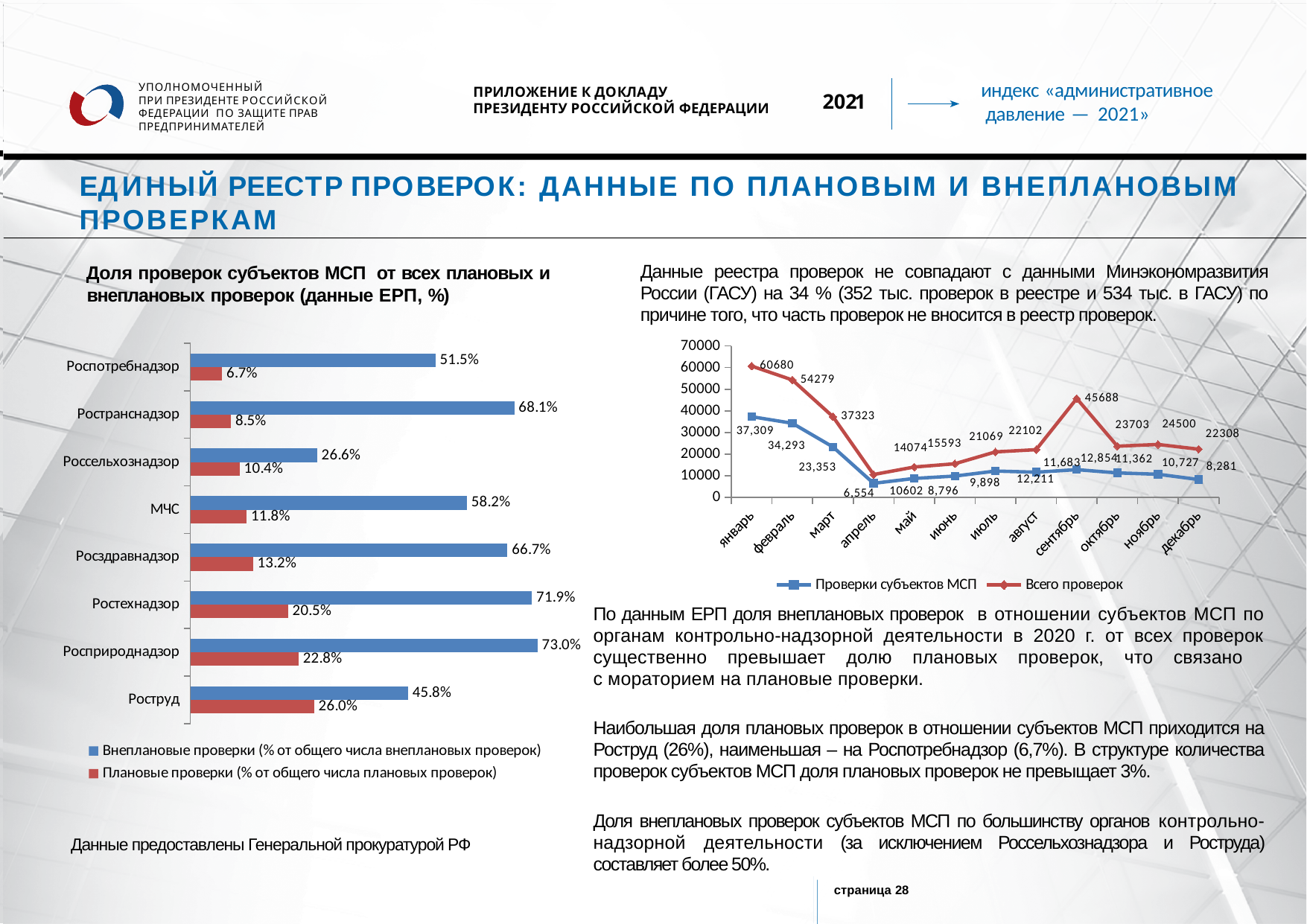
On the right line chart, what is the value of Проверки субъектов МСП in январь? 37,309 How many agencies are listed on the left bar chart? 8 On the left bar chart, what is the value of unscheduled inspections (Внеплановые проверки) for Росприроднадзор? 73.0% On the right line chart, what is the value of Всего проверок in сентябрь? 45688 On the left bar chart, what is the difference between the unscheduled and scheduled inspection shares for МЧС? 46.4% On the left bar chart, what is the value of scheduled inspections (Плановые проверки) for Роструд? 26.0% On the left bar chart, which agency has the lowest share of scheduled inspections? Роспотребнадзор What type of chart is the chart on the left of the slide? Bar chart On the left bar chart, which is larger: the unscheduled inspection share for Ространснадзор or for Росздравнадзор? Ространснадзор How many series does the legend of the right line chart list? 2 On the right line chart, in which month is Всего проверок lowest? апрель On the left bar chart, which agency has the highest share of unscheduled inspections? Росприроднадзор